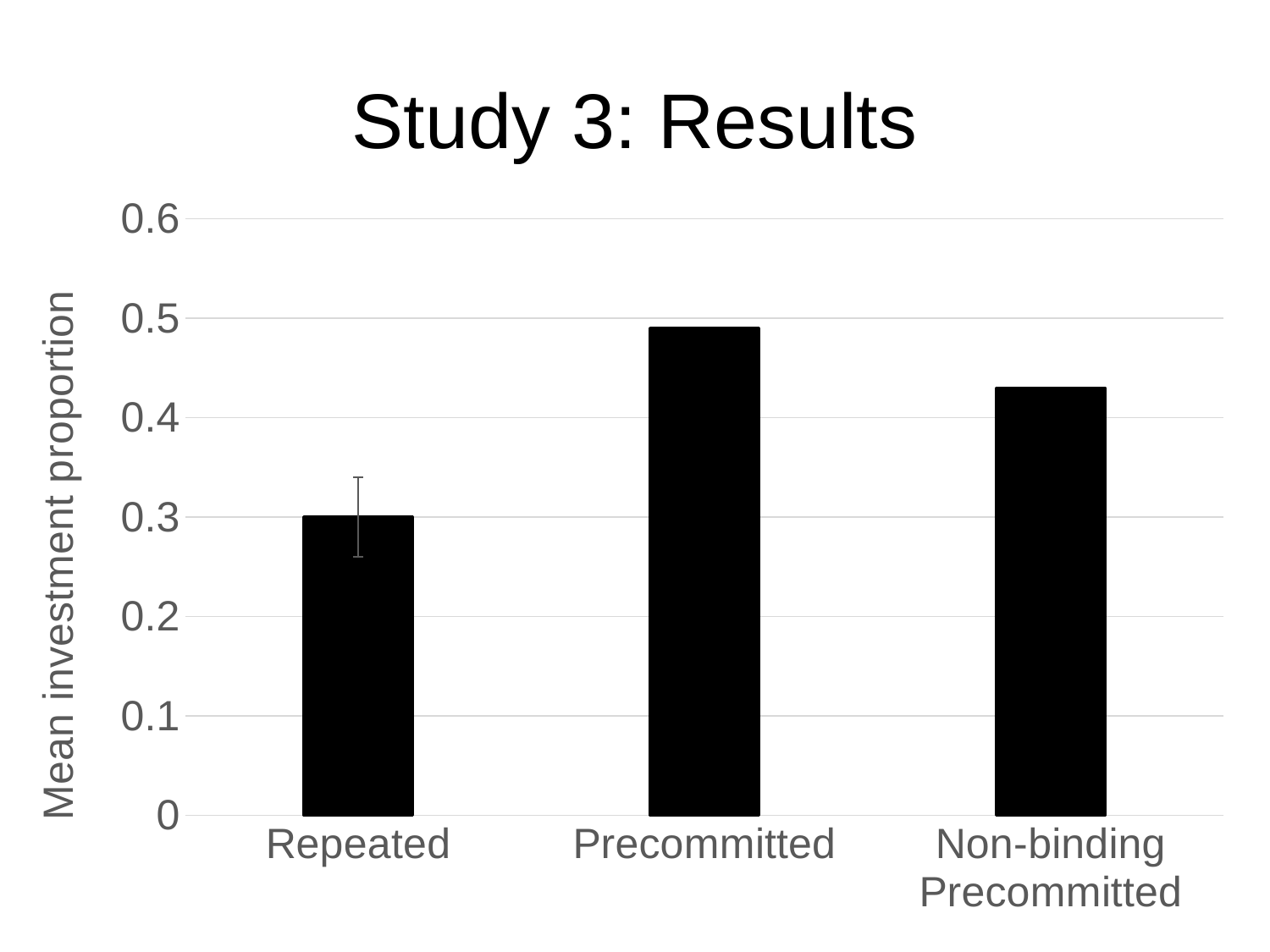
Which is larger, the value for Repeated or the value for Non-binding Precommitted? Non-binding Precommitted Is the value for Precommitted greater or less than 0.4? greater Is the value for Non-binding Precommitted greater or less than 0.4? greater What is the title of the slide? Study 3: Results Which is larger, the value for Precommitted or the value for Non-binding Precommitted? Precommitted Is the value for Repeated greater or less than 0.4? less Which category has the highest mean investment proportion? Precommitted How many categories are shown on the x axis? 3 What kind of chart is shown on the slide? bar chart Which category has the lowest mean investment proportion? Repeated What is the label on the y axis? Mean investment proportion